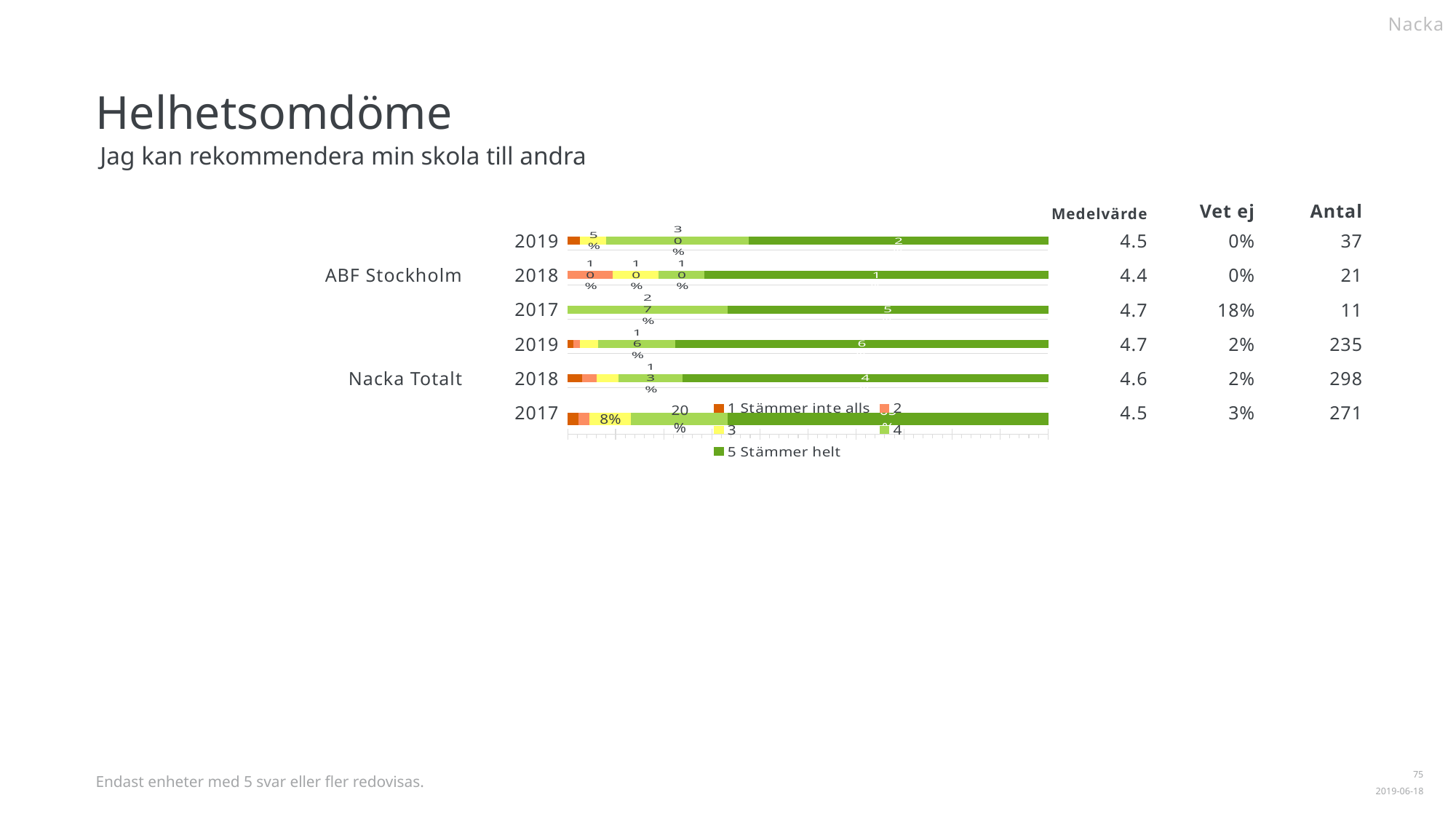
How many series does the chart legend list? 5 How many bars are plotted in the chart? 6 Which is larger for ABF Stockholm 2019: the '3' segment or the '4' segment? 4 What kind of chart is shown on the slide? Stacked bar chart What is the value of the '4' segment for ABF Stockholm 2019? 30% What is the label of the last legend entry? 5 Stämmer helt What is the value of the '4' segment for Nacka Totalt 2017? 20% What is the label of the first legend entry? 1 Stämmer inte alls What is the value of the '4' segment for ABF Stockholm 2017? 27% What is the value of the '3' segment for ABF Stockholm 2019? 5% What is the value of the '3' segment for Nacka Totalt 2017? 8% Which series has the largest segment in the Nacka Totalt 2019 bar? 5 Stämmer helt